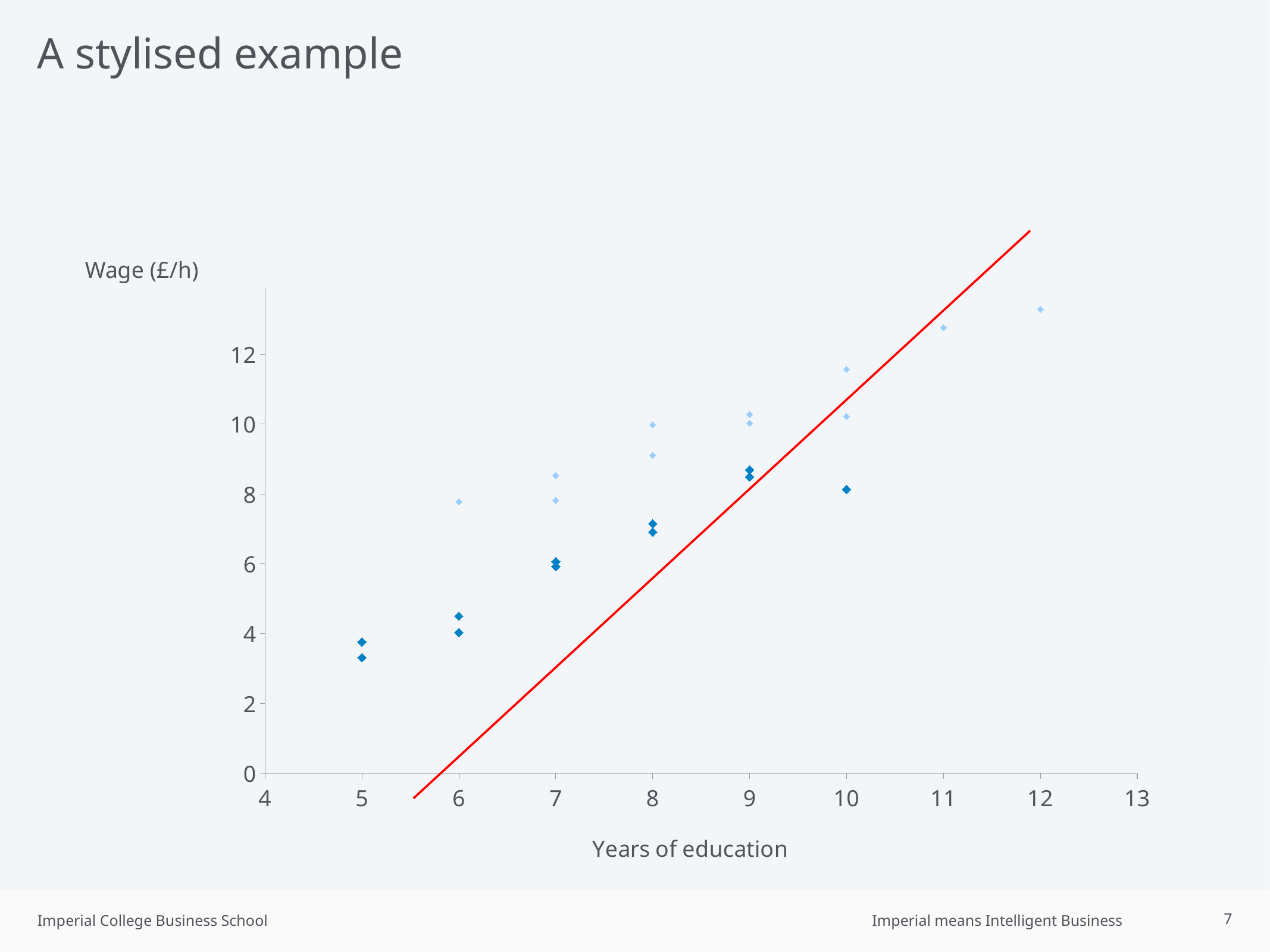
What kind of chart is shown on the slide? Scatter chart Is the wage value at 11 years of education greater or less than 12? greater Are the wage values for 5 years of education greater or less than 4? less What is the label of the vertical axis? Wage (£/h) What is the label of the horizontal axis? Years of education Are the dark blue wage values at 8 years of education greater or less than 6? greater What is the title of the slide containing the chart? A stylised example Which has the higher plotted wage: the point at 12 years of education or the point at 11 years of education? 12 years of education Do wages generally rise or fall as years of education increase? Rise